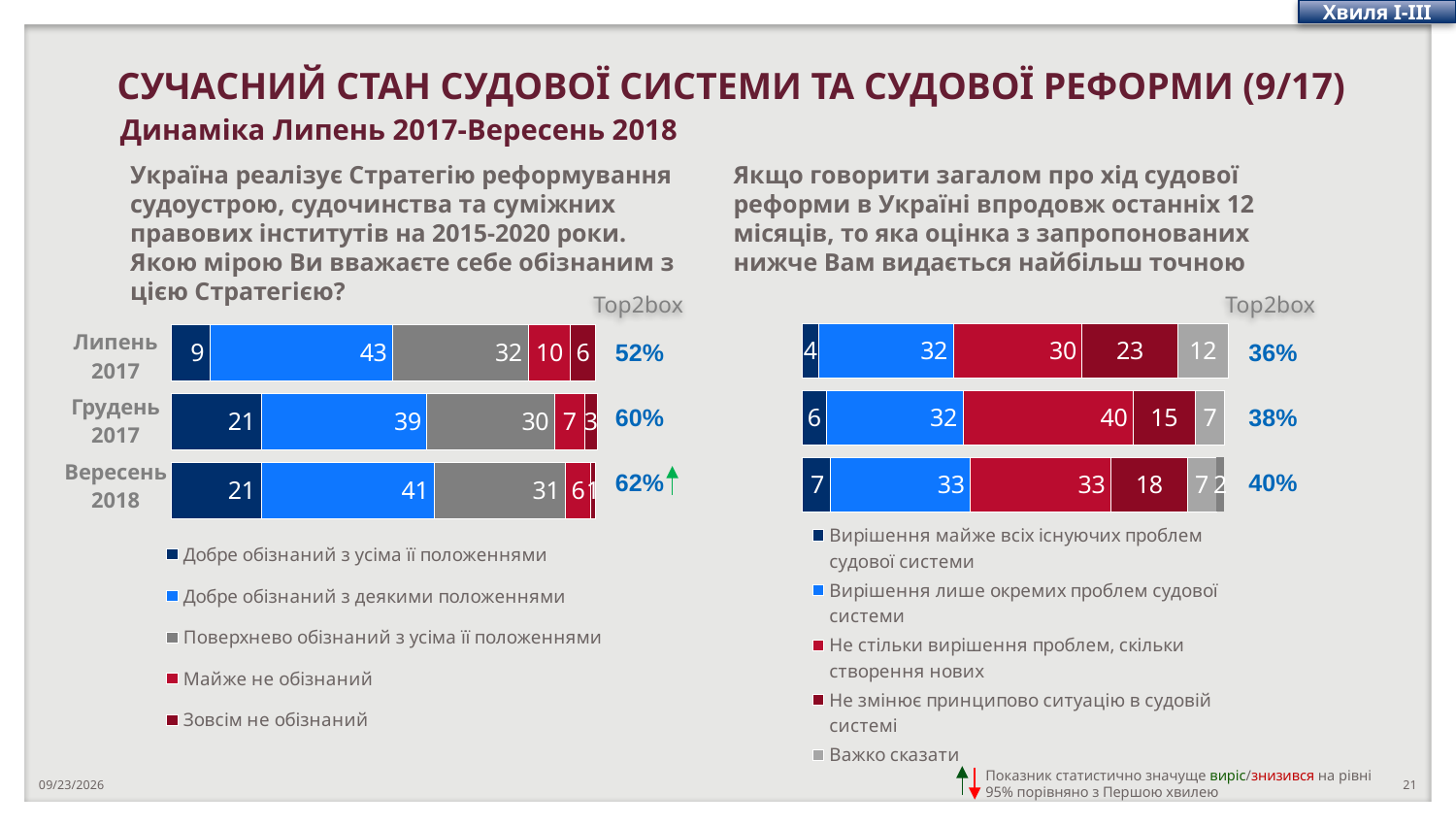
In the left chart, how many series does the legend list? 5 In the left chart (awareness of the Strategy), what is the value of the 'Добре обізнаний з деякими положеннями' segment for Липень 2017? 43 What type of chart is used on this slide? Stacked bar chart In the right chart (assessment of judicial reform), what is the value of the 'Не стільки вирішення проблем, скільки створення нових' segment in the middle bar (Грудень 2017)? 40 In the right chart, which bar has the highest Top2box value? Вересень 2018 (bottom bar) In the left chart, what is the difference between the Top2box values for Грудень 2017 and Липень 2017? 8 percentage points In the right chart, what is the Top2box value for the bottom bar (Вересень 2018)? 40% In the left chart, what is the Top2box value for Вересень 2018? 62% Do the Top2box values in the right chart rise or fall from Липень 2017 to Вересень 2018? Rise In the right chart, is the 'Важко сказати' value in the top bar (Липень 2017) larger or smaller than in the middle bar (Грудень 2017)? Larger In the left chart, what is the value of the 'Добре обізнаний з усіма її положеннями' segment for Грудень 2017? 21 In the left chart, which period has the lowest Top2box value? Липень 2017